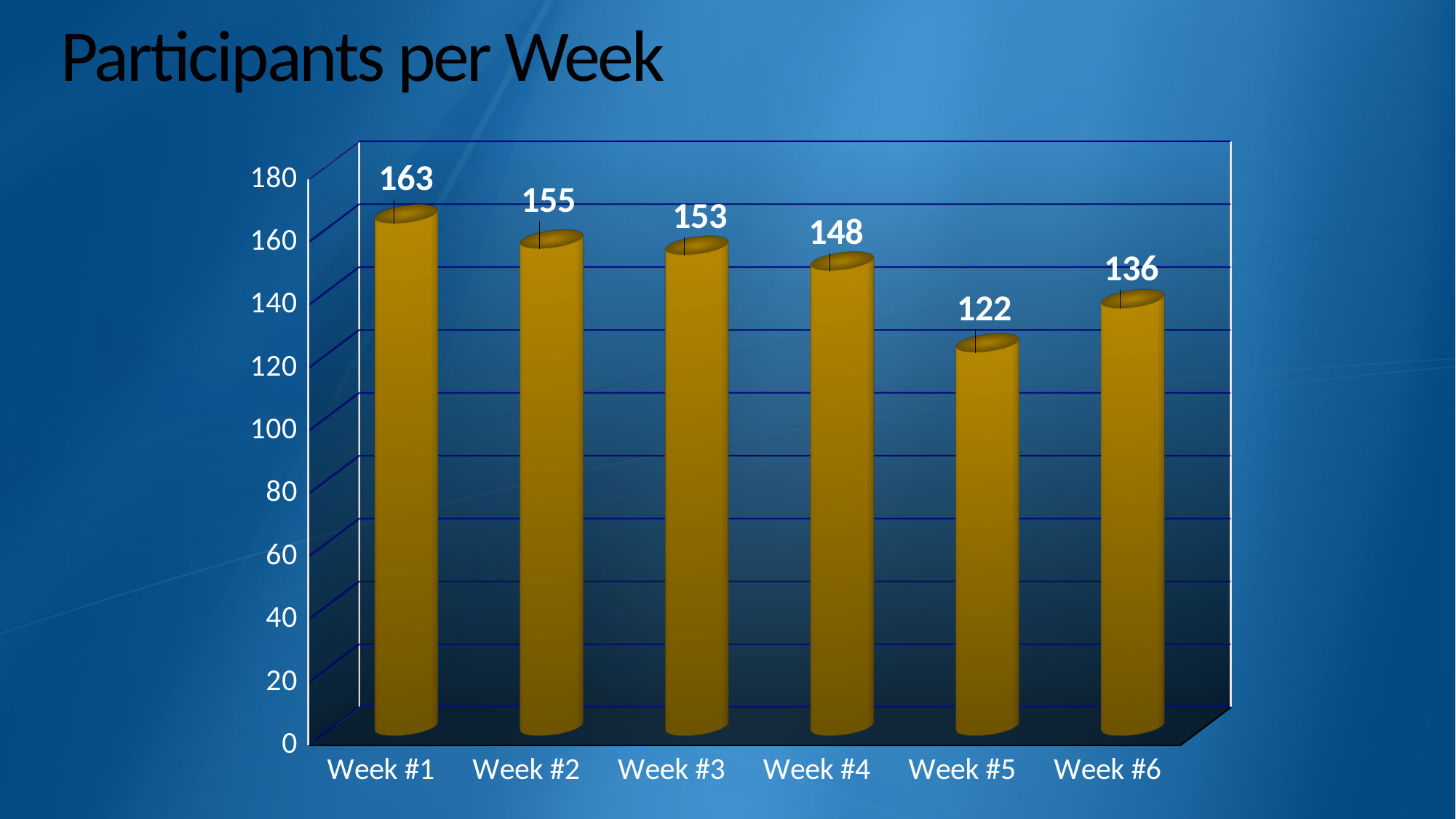
What is the difference between the values for Week #1 and Week #5? 41 Which is larger, the value for Week #4 or the value for Week #6? Week #4 Which week has the lowest number of participants? Week #5 What kind of chart is shown on the slide? bar chart What is the value for Week #1? 163 What is the value for Week #4? 148 What is the difference between the values for Week #2 and Week #3? 2 How many weeks are shown on the chart? 6 What is the title of the chart? Participants per Week What is the value for Week #6? 136 Is the value for Week #5 greater or less than 140? less Which week has the highest number of participants? Week #1